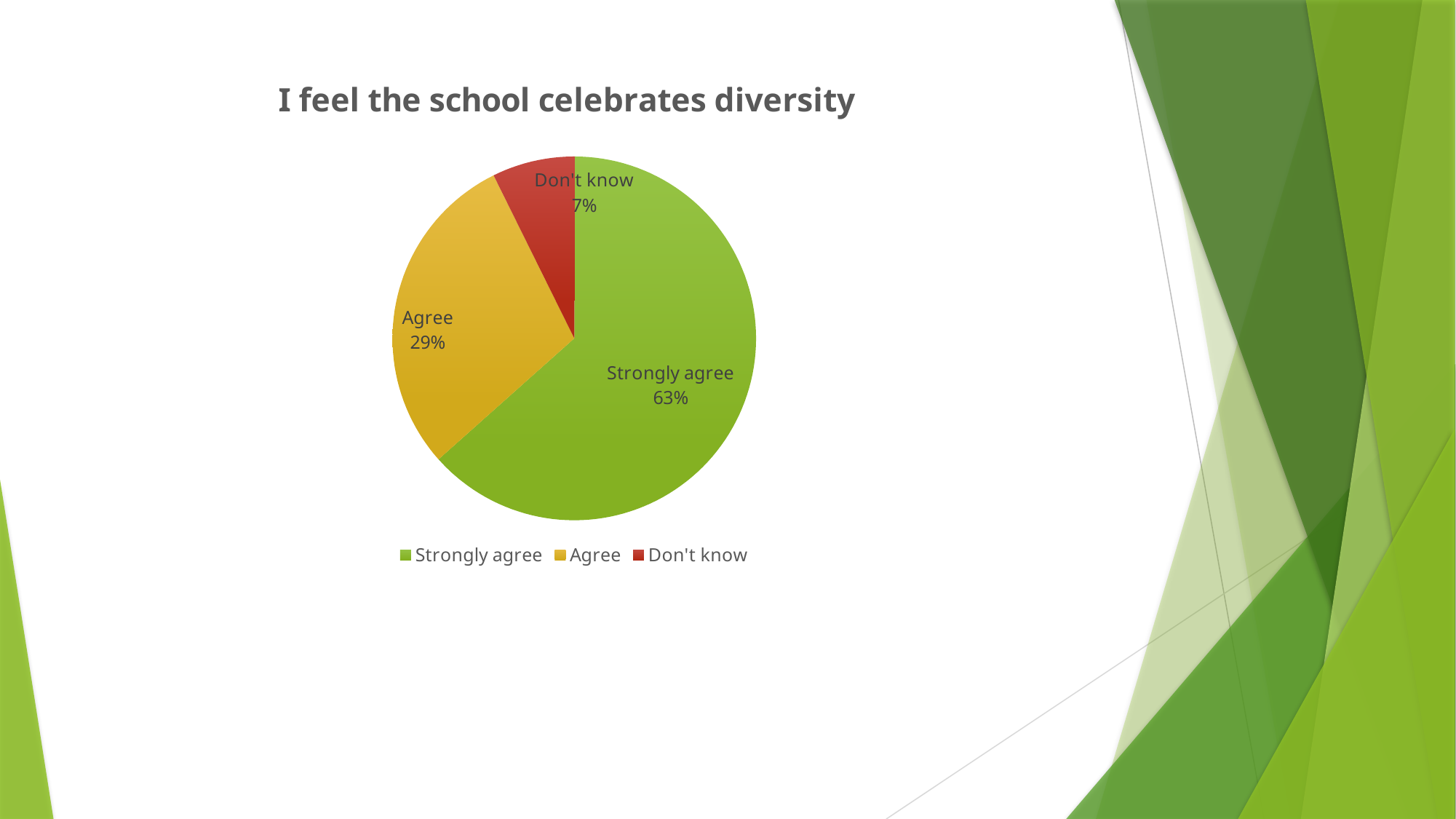
What kind of chart is shown on the slide? Pie chart What colour is the 'Don't know' slice? Red Which is larger, the share for 'Agree' or the share for 'Don't know'? Agree What percentage of respondents chose 'Don't know'? 7% Which response has the smallest share of the pie? Don't know What percentage of respondents chose 'Agree'? 29% Which response has the largest share of the pie? Strongly agree What is the difference in percentage points between 'Strongly agree' and 'Agree'? 34 How many slices does the pie chart have? 3 What is the title of the chart? I feel the school celebrates diversity What is the difference in percentage points between 'Agree' and 'Don't know'? 22 What percentage of respondents chose 'Strongly agree'? 63%